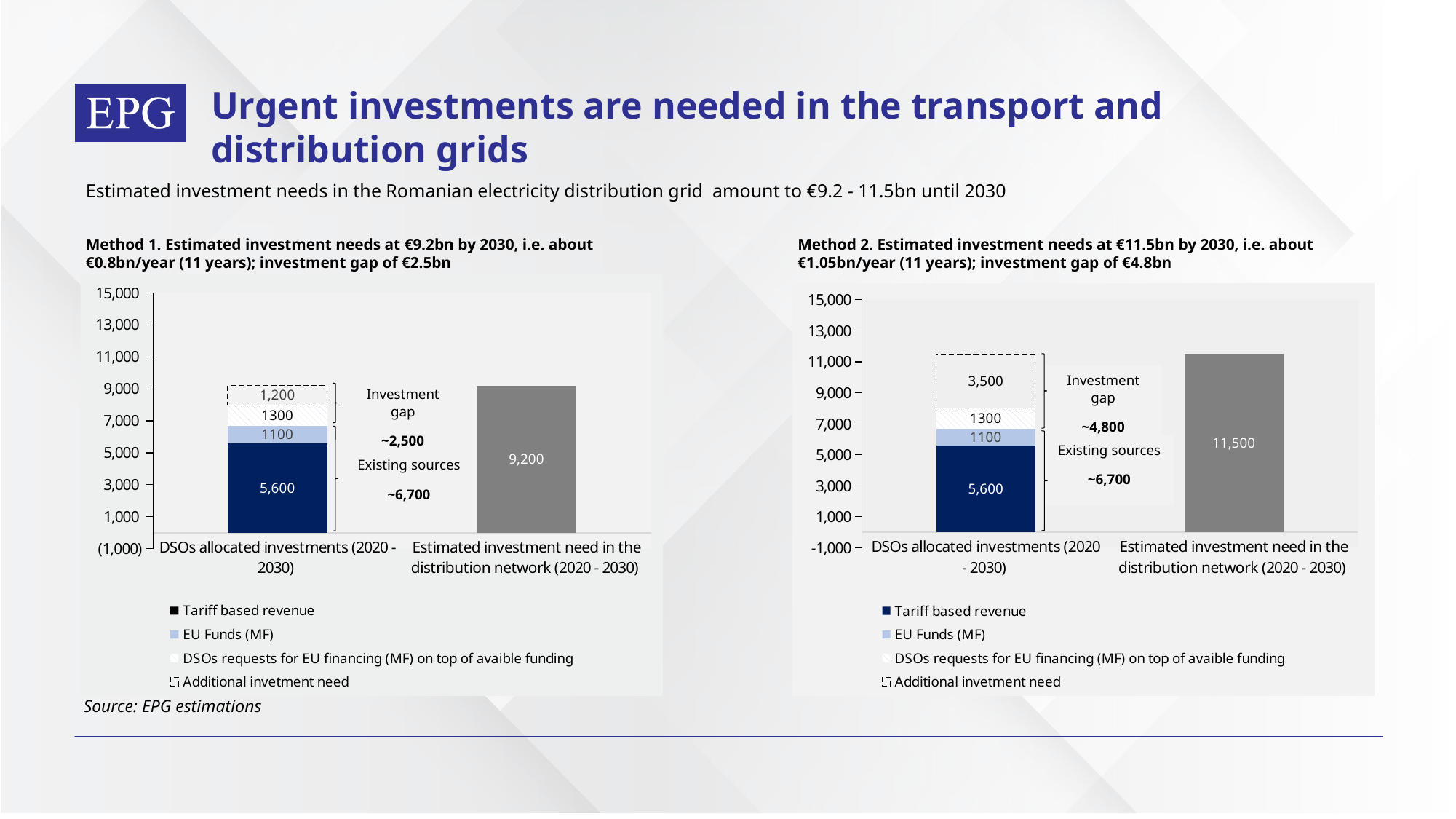
What is the difference between the Estimated investment need bar in the Method 2 chart and the Estimated investment need bar in the Method 1 chart? 2,300 In the Method 2 chart, what is the difference between the Additional investment need segment and the DSOs requests for EU financing segment? 2,200 In the Method 2 chart, what is the total of the stacked DSOs allocated investments (2020 - 2030) bar? 11,500 In the Method 1 chart, which legend entry is shown with a dashed outline? Additional invetment need In the Method 1 chart, what is the value of the EU Funds (MF) segment? 1100 In the Method 1 chart, what is the total of the stacked DSOs allocated investments (2020 - 2030) bar? 9,200 What kind of chart is the Method 2 chart? Stacked bar chart In the Method 1 chart, what is the value of the Estimated investment need in the distribution network (2020 - 2030) bar? 9,200 How many series does the legend of the Method 1 chart list? 4 In the Method 2 chart, what is the value of the Estimated investment need in the distribution network (2020 - 2030) bar? 11,500 In the Method 2 chart, what is the value of the Additional investment need segment in the DSOs allocated investments bar? 3,500 In the Method 1 chart, what is the value of the Tariff based revenue segment in the DSOs allocated investments bar? 5,600